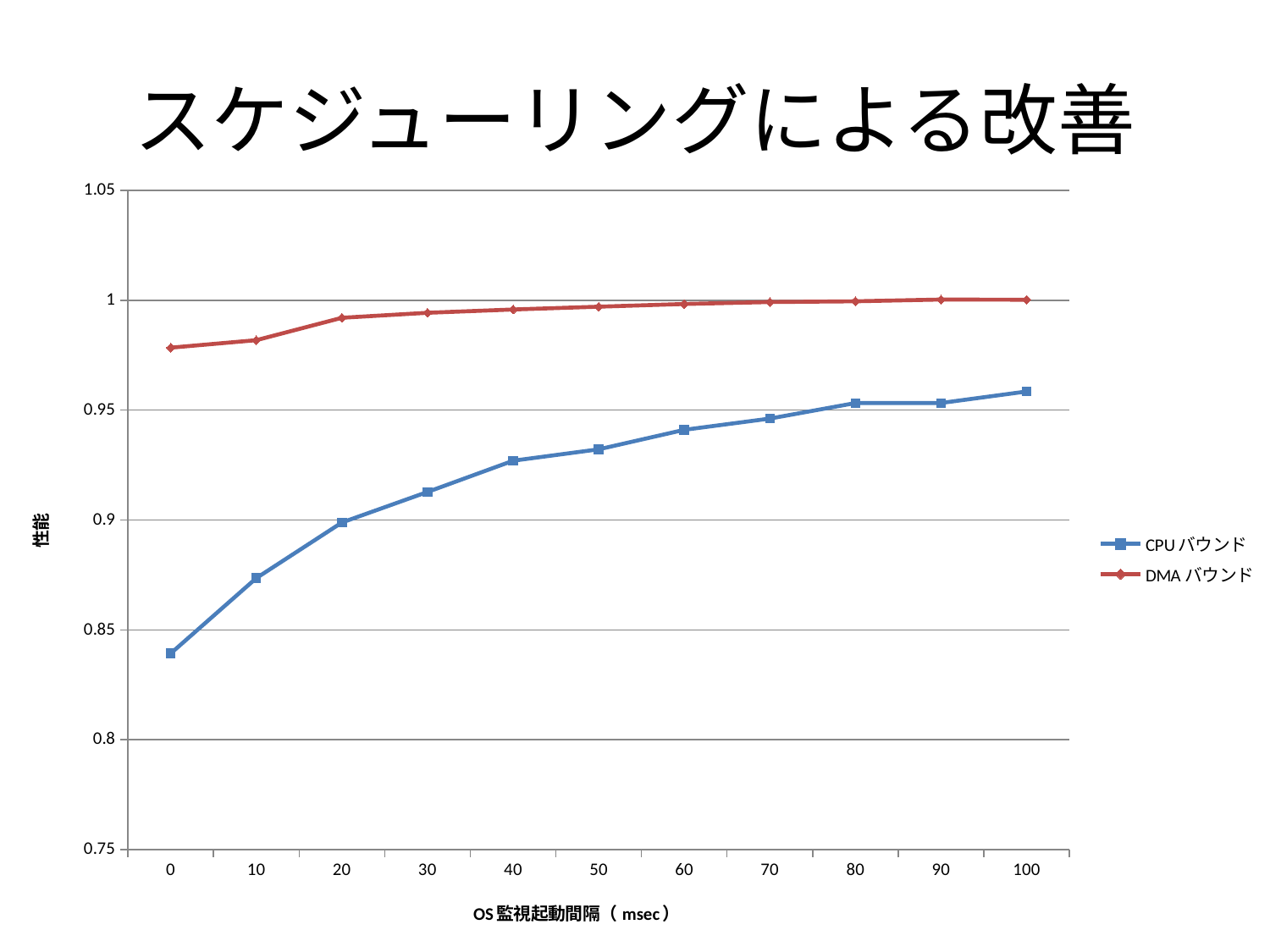
What kind of chart is shown on the slide? line chart Is the value for CPU バウンド at 100 msec greater or less than 0.95? greater Is the value for DMA バウンド at 0 msec greater or less than 1? less How many data points are plotted for the CPU バウンド series? 11 Is the value for CPU バウンド at 50 msec greater or less than 0.95? less Does the CPU バウンド series rise or fall as the OS 監視起動間隔 increases from 0 to 100 msec? rise What is the label of the x axis? OS 監視起動間隔 ( msec ) How many series does the legend list? 2 What is the title of the chart on the slide? スケジューリングによる改善 At 0 msec, which series has the larger value, CPU バウンド or DMA バウンド? DMA バウンド